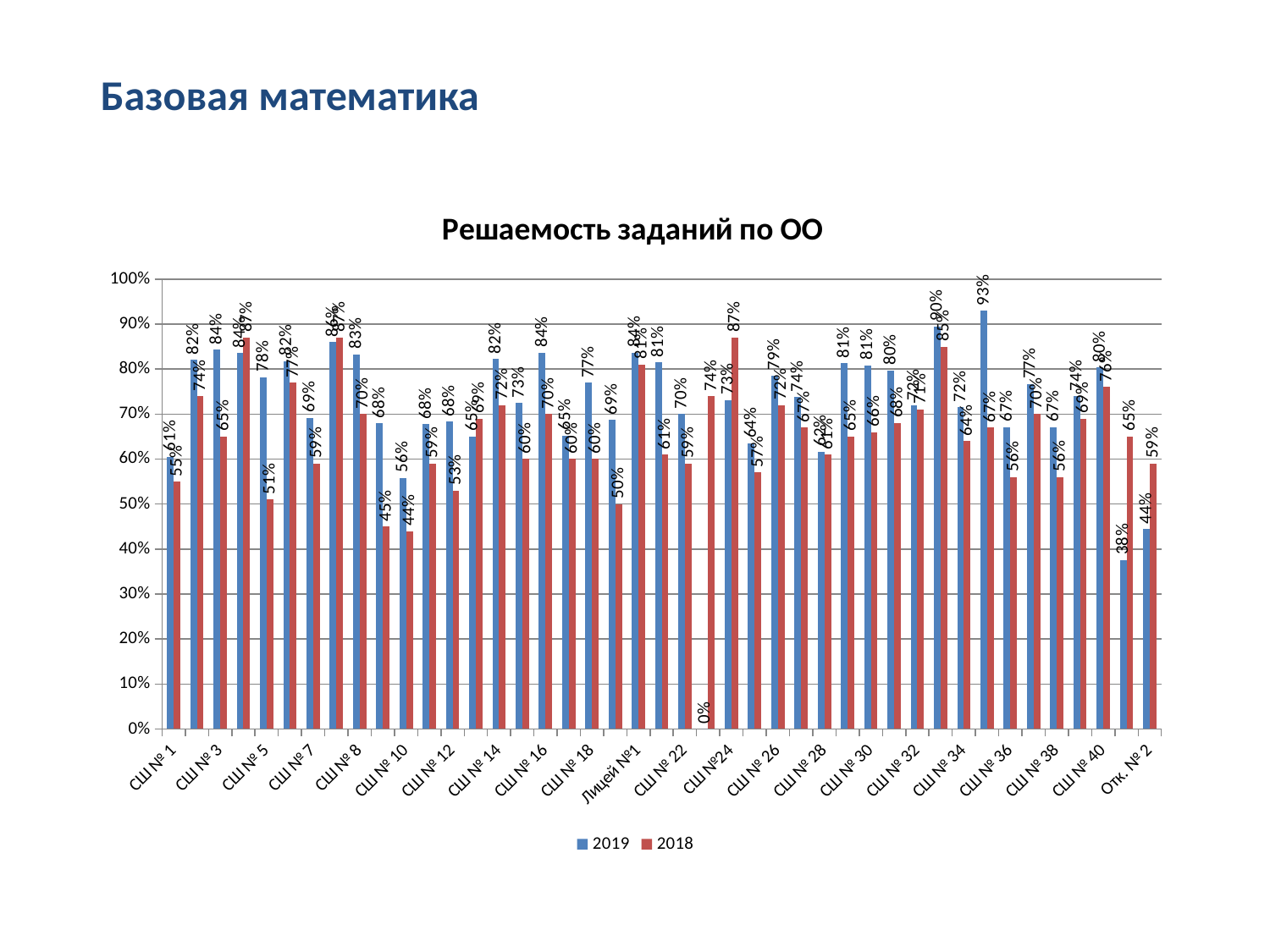
For СШ № 5, which year has the larger value, 2019 or 2018? 2019 What is the highest value in the 2019 series? 93% What kind of chart is shown on the slide? bar chart What is the 2019 value for СШ № 10? 56% What is the 2018 value for СШ № 1? 55% What is the 2018 value for СШ № 5? 51% What is the 2019 value for СШ № 1? 61% What is the title of the chart? Решаемость заданий по ОО What is the lowest value in the 2018 series? 44% What is the difference between the 2019 and 2018 values for СШ № 1? 6% What is the 2018 value for СШ №24? 87% How many series does the legend list? 2